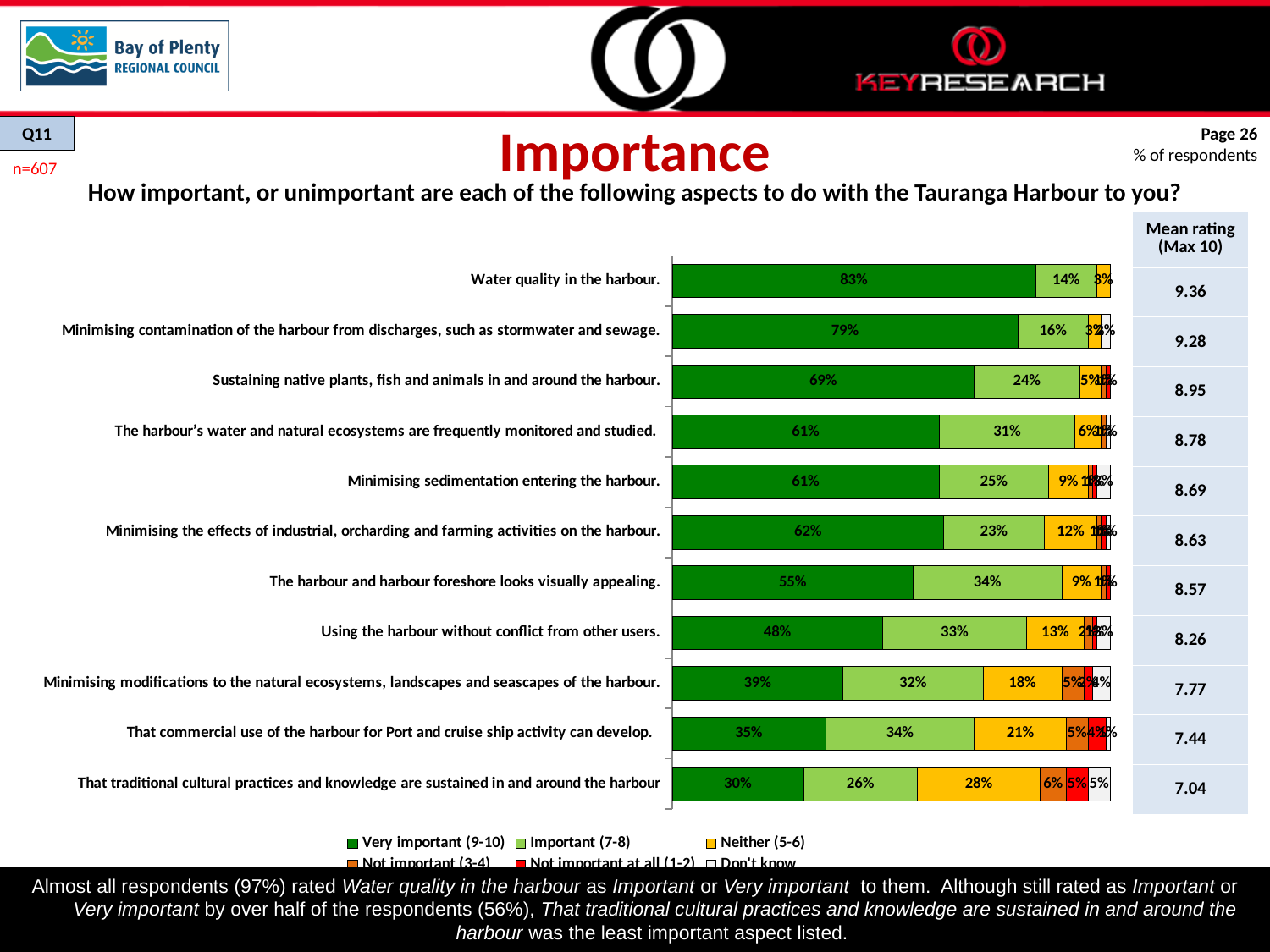
Which has a larger Important (7-8) percentage: 'The harbour's water and natural ecosystems are frequently monitored and studied' or 'Minimising sedimentation entering the harbour'? The harbour's water and natural ecosystems are frequently monitored and studied. What percentage of respondents rated 'Water quality in the harbour' as Very important (9-10)? 83% Which aspect has the lowest Very important (9-10) percentage? That traditional cultural practices and knowledge are sustained in and around the harbour What kind of chart is shown on the slide? Stacked bar chart Which aspect has the highest Very important (9-10) percentage? Water quality in the harbour. How many harbour aspects (categories) are plotted in the chart? 11 What is the Neither (5-6) value for 'That traditional cultural practices and knowledge are sustained in and around the harbour'? 28% What colour represents the Very important (9-10) series in the chart? Dark green What percentage rated 'The harbour and harbour foreshore looks visually appealing' as Important (7-8)? 34% How many series does the chart legend list? 6 What is the difference in the Very important (9-10) percentage between 'Water quality in the harbour' and 'That traditional cultural practices and knowledge are sustained in and around the harbour'? 53 percentage points What is the Neither (5-6) value for 'That commercial use of the harbour for Port and cruise ship activity can develop'? 21%